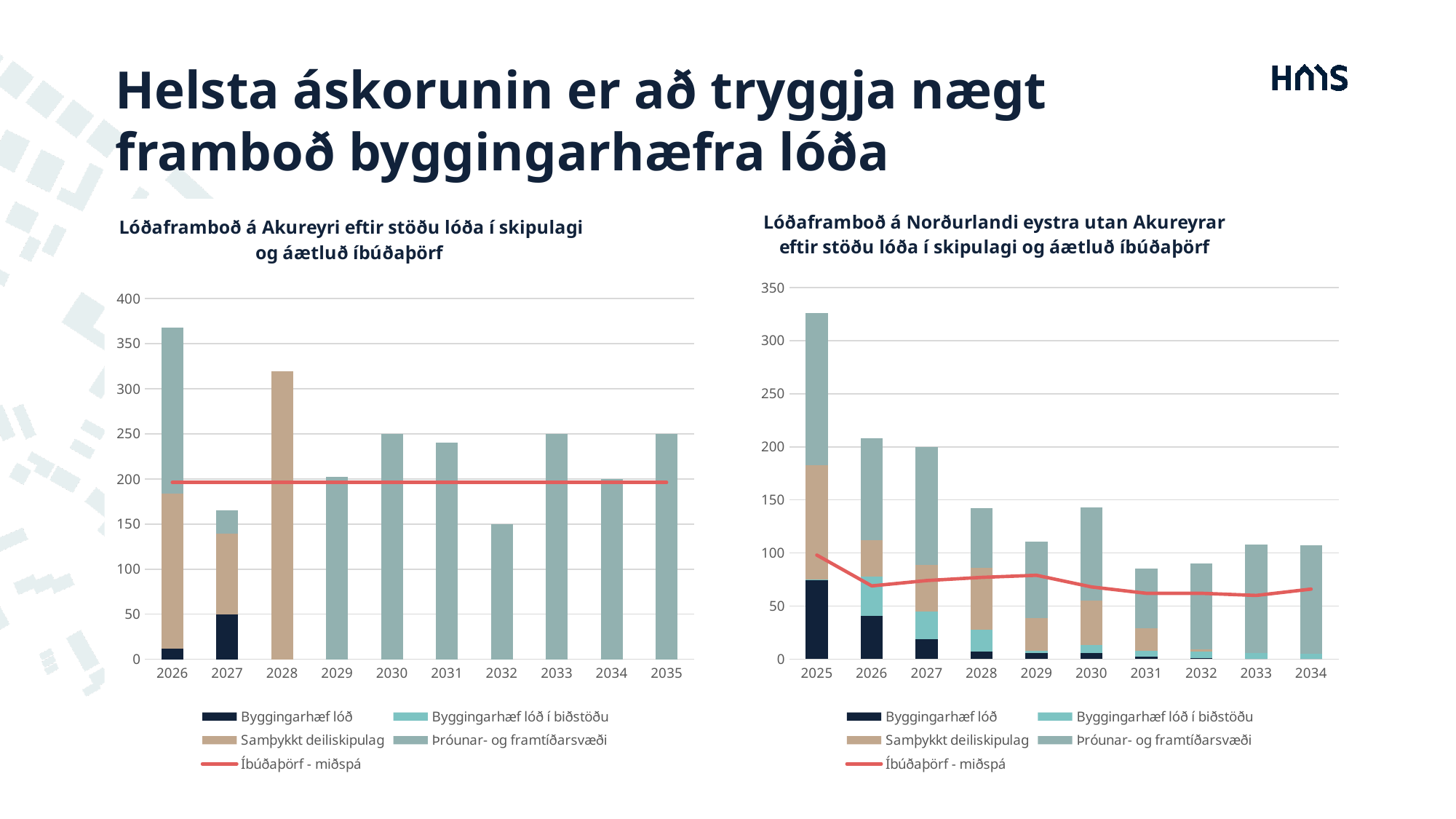
In the left chart (Akureyri), which year has the tallest stacked bar? 2026 In the left chart (Akureyri), which year has the larger total bar, 2026 or 2028? 2026 In the right chart (Norðurland eystra utan Akureyrar), what is the name of the series drawn as a red line? Íbúðaþörf - miðspá In the left chart (Akureyri), how many years are shown on the x axis? 10 In the right chart (Norðurland eystra utan Akureyrar), which year has the tallest stacked bar? 2025 In the left chart (Akureyri), which year has the shortest stacked bar? 2032 In the left chart (Akureyri), is the total bar for 2032 greater or less than 200? less In the left chart (Akureyri), how many entries does the legend list? 5 In the left chart (Akureyri), is the total bar for 2028 greater or less than 300? greater In the right chart (Norðurland eystra utan Akureyrar), is the total bar for 2025 greater or less than 300? greater What kind of chart is the left chart, 'Lóðaframboð á Akureyri eftir stöðu lóða í skipulagi og áætluð íbúðaþörf'? Bar chart (stacked, with a line) In the right chart (Norðurland eystra utan Akureyrar), do the total bar heights generally rise or fall from 2025 to 2034? fall